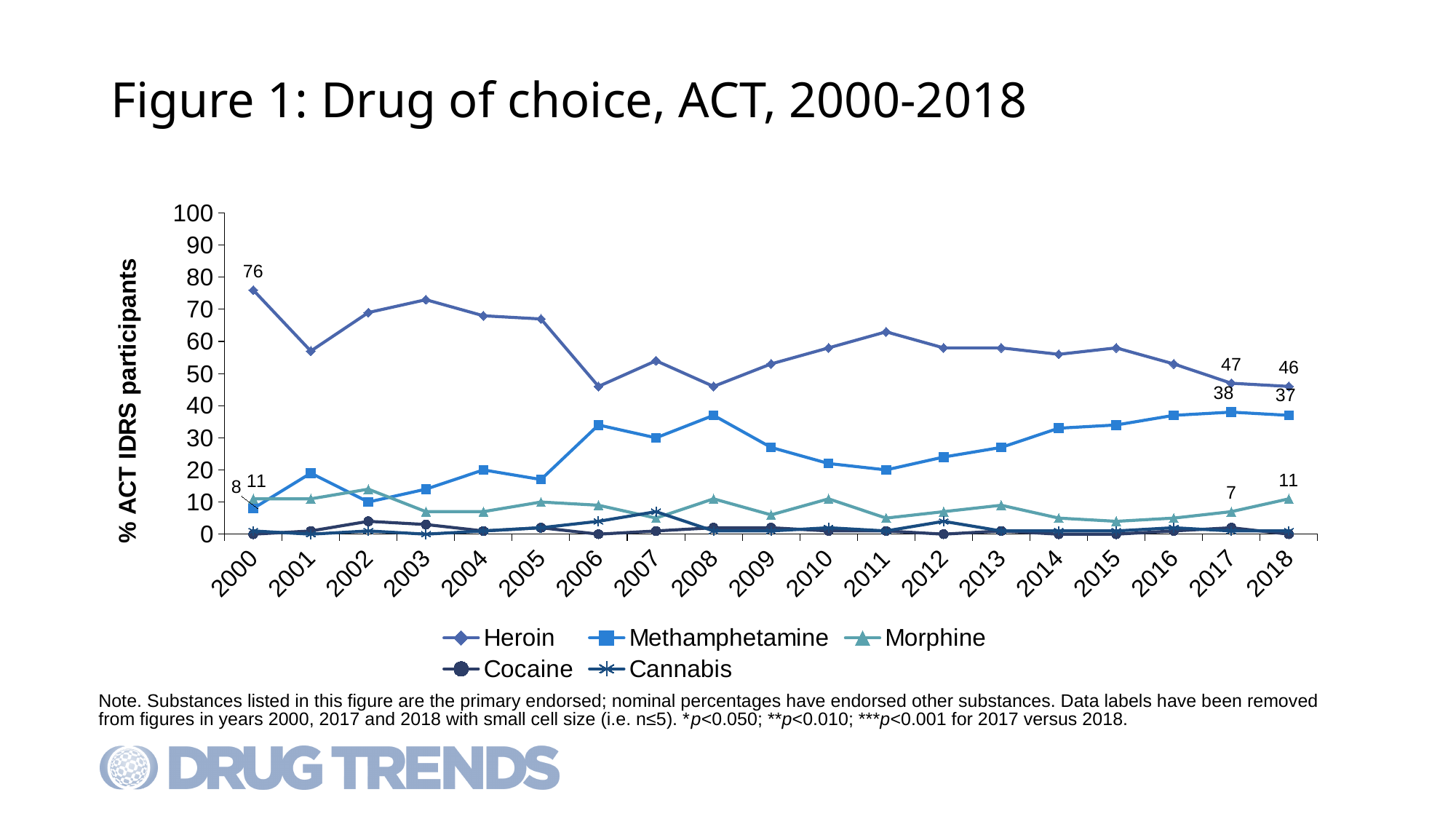
What is the label on the y axis? % ACT IDRS participants Did the Heroin value rise or fall overall from 2000 to 2018? fall By how much did the Heroin value fall between 2000 and 2018? 30 In 2018, which was larger: Heroin or Methamphetamine? Heroin What kind of chart is shown? line chart Is the value for Methamphetamine in 2011 greater or less than 30? less What was the value for Methamphetamine in 2000? 8 How many years are shown on the x axis? 19 How many series does the legend list? 5 What was the value for Methamphetamine in 2018? 37 What was the value for Morphine in 2017? 7 What was the value for Heroin in 2000? 76